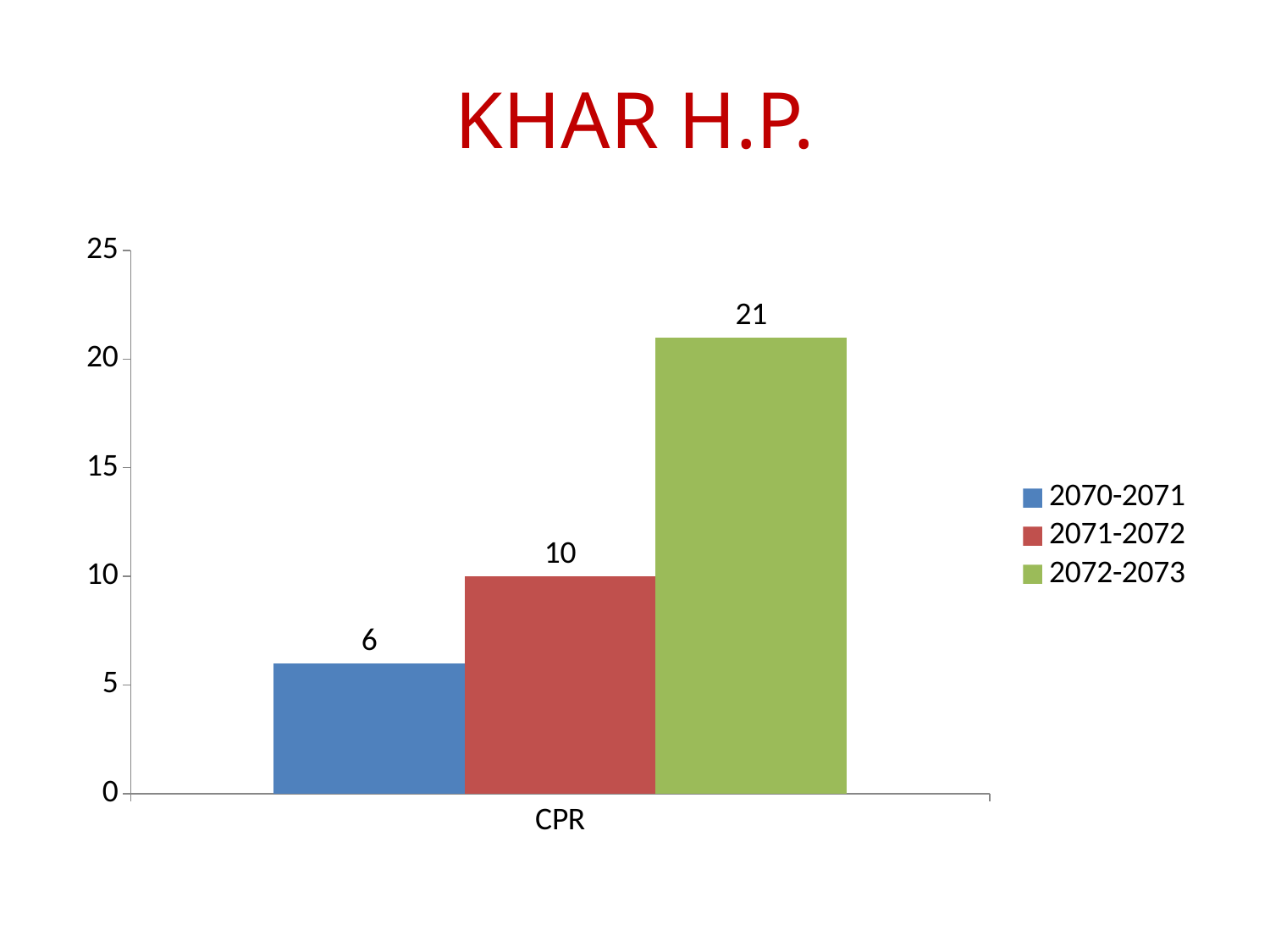
What kind of chart is shown on the slide? bar chart What is the difference between the CPR values for 2071-2072 and 2070-2071? 4 Which series has the highest CPR value? 2072-2073 What is the difference between the CPR values for 2072-2073 and 2071-2072? 11 Which series has the lowest CPR value? 2070-2071 What is the CPR value for 2071-2072? 10 How many series does the legend list? 3 Which is larger, the CPR value for 2070-2071 or for 2071-2072? 2071-2072 What is the CPR value for 2070-2071? 6 Is the CPR value for 2072-2073 greater or less than 20? greater What is the CPR value for 2072-2073? 21 What is the title of the slide? KHAR H.P.